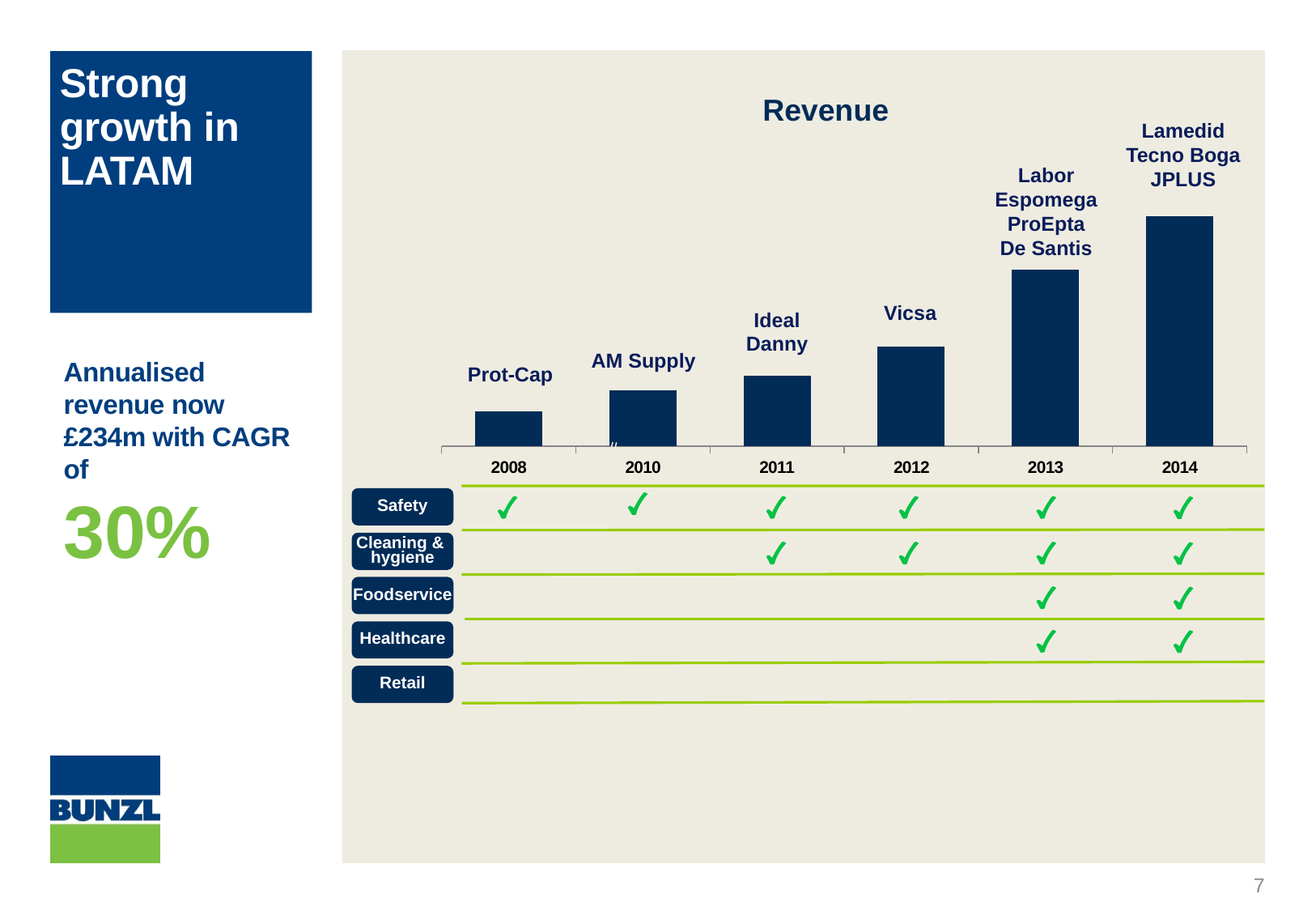
Which year has the highest revenue bar? 2014 What is the last year shown on the x axis of the Revenue chart? 2014 Which year has the larger revenue bar, 2008 or 2010? 2010 Do the revenue bars rise or fall from 2008 to 2014? rise What is the first year shown on the x axis of the Revenue chart? 2008 How many years are shown on the x axis of the Revenue chart? 6 What is the title of the chart? Revenue What kind of chart is shown on the slide? bar chart Which year has the lowest revenue bar? 2008 Which year has the larger revenue bar, 2012 or 2013? 2013 Which year has the larger revenue bar, 2010 or 2011? 2011 Which company name is labelled above the 2012 bar in the Revenue chart? Vicsa